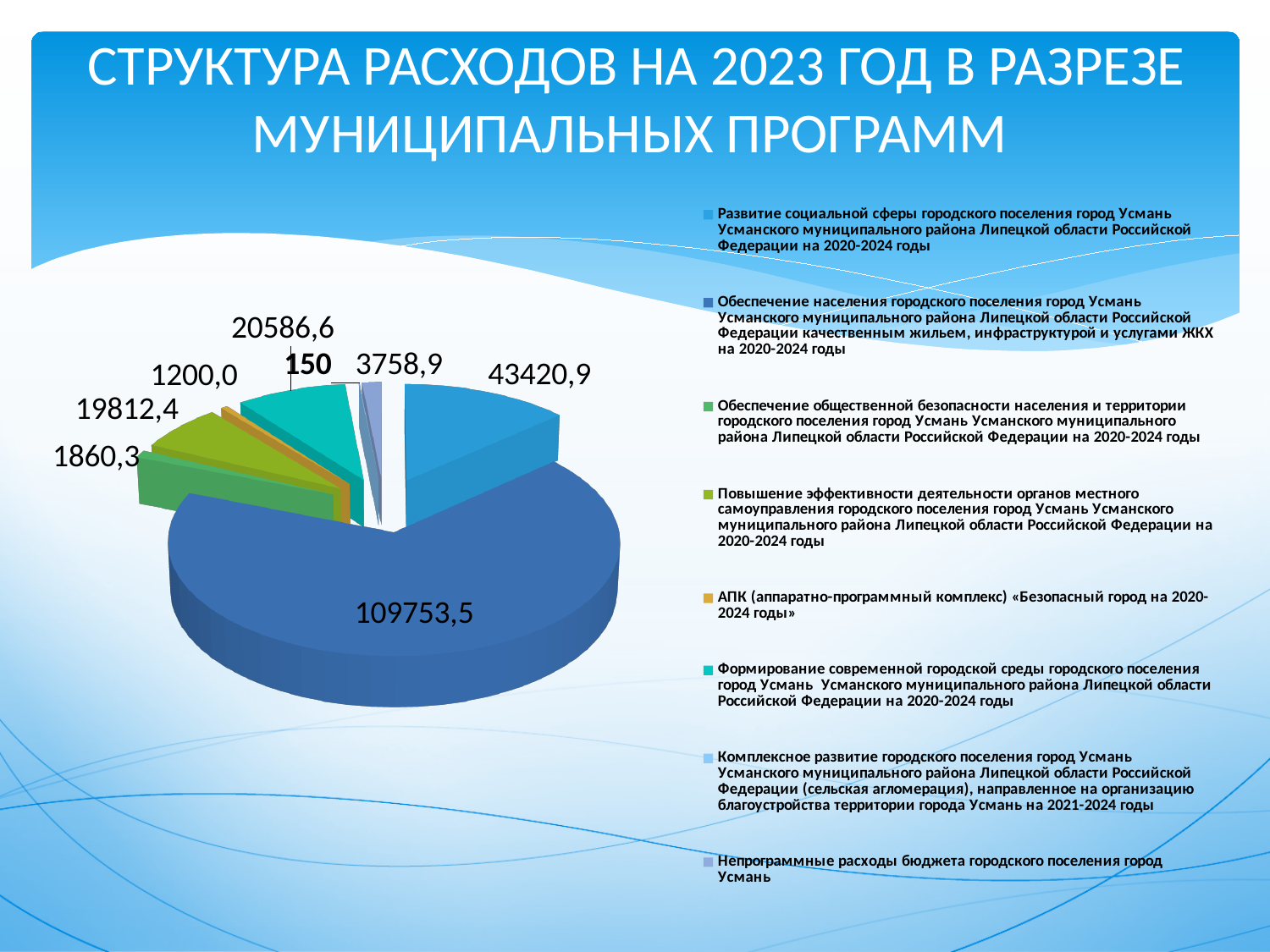
What is the value for «Развитие социальной сферы городского поселения город Усмань ... на 2020-2024 годы»? 43420,9 What is the value for «Непрограммные расходы бюджета городского поселения город Усмань»? 3758,9 Which program has the largest slice of the pie? Обеспечение населения ... качественным жильем, инфраструктурой и услугами ЖКХ на 2020-2024 годы What is the value for «Обеспечение населения ... качественным жильем, инфраструктурой и услугами ЖКХ на 2020-2024 годы»? 109753,5 How many entries does the legend list? 8 How many slices does the pie chart have? 8 What is the value for «АПК (аппаратно-программный комплекс) «Безопасный город на 2020-2024 годы»»? 1200,0 What is the value for «Формирование современной городской среды ... на 2020-2024 годы»? 20586,6 What type of chart is shown on the slide? Pie chart What is the difference between the value for «Обеспечение населения ... услугами ЖКХ» (109753,5) and «Развитие социальной сферы» (43420,9)? 66332,6 Which is larger: the value for «Формирование современной городской среды» or «Повышение эффективности деятельности органов местного самоуправления»? Формирование современной городской среды Which category has the smallest value in the pie chart? Комплексное развитие городского поселения город Усмань ... (сельская агломерация) на 2021-2024 годы